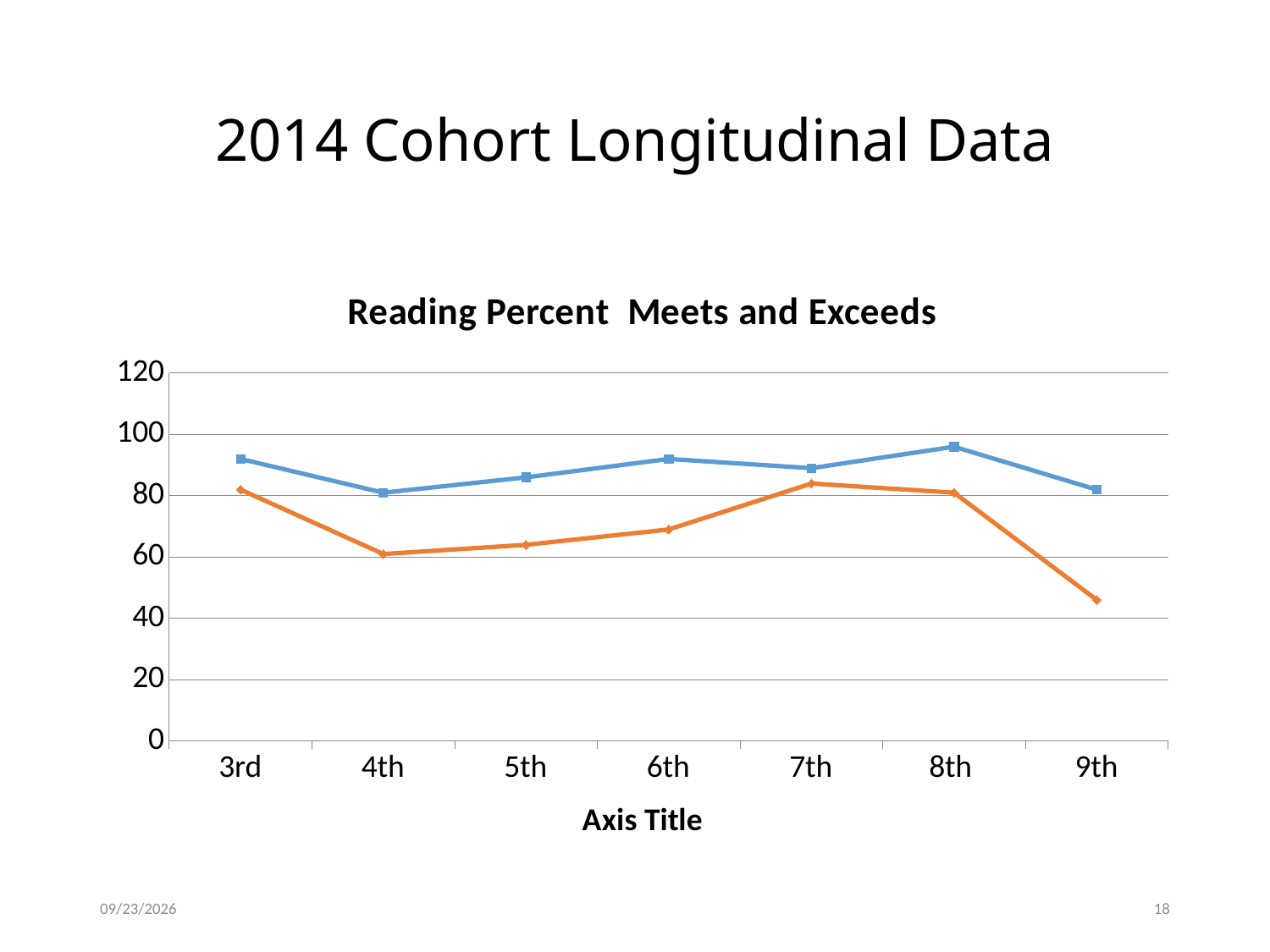
Is the value of the blue line at 8th greater or less than 100? less What kind of chart is shown on the slide? line chart Is the value of the orange line at 6th greater or less than 80? less Is the value of the blue line at 3rd greater or less than 80? greater Does the orange line rise or fall from 4th to 7th? rise What is the title of the chart? Reading Percent Meets and Exceeds Does the orange line rise or fall from 8th to 9th? fall How many grade levels are plotted along the x axis? 7 At which grade is the orange line at its lowest? 9th What is the label shown under the x axis? Axis Title At 9th, which line has the higher value, the blue line or the orange line? blue line